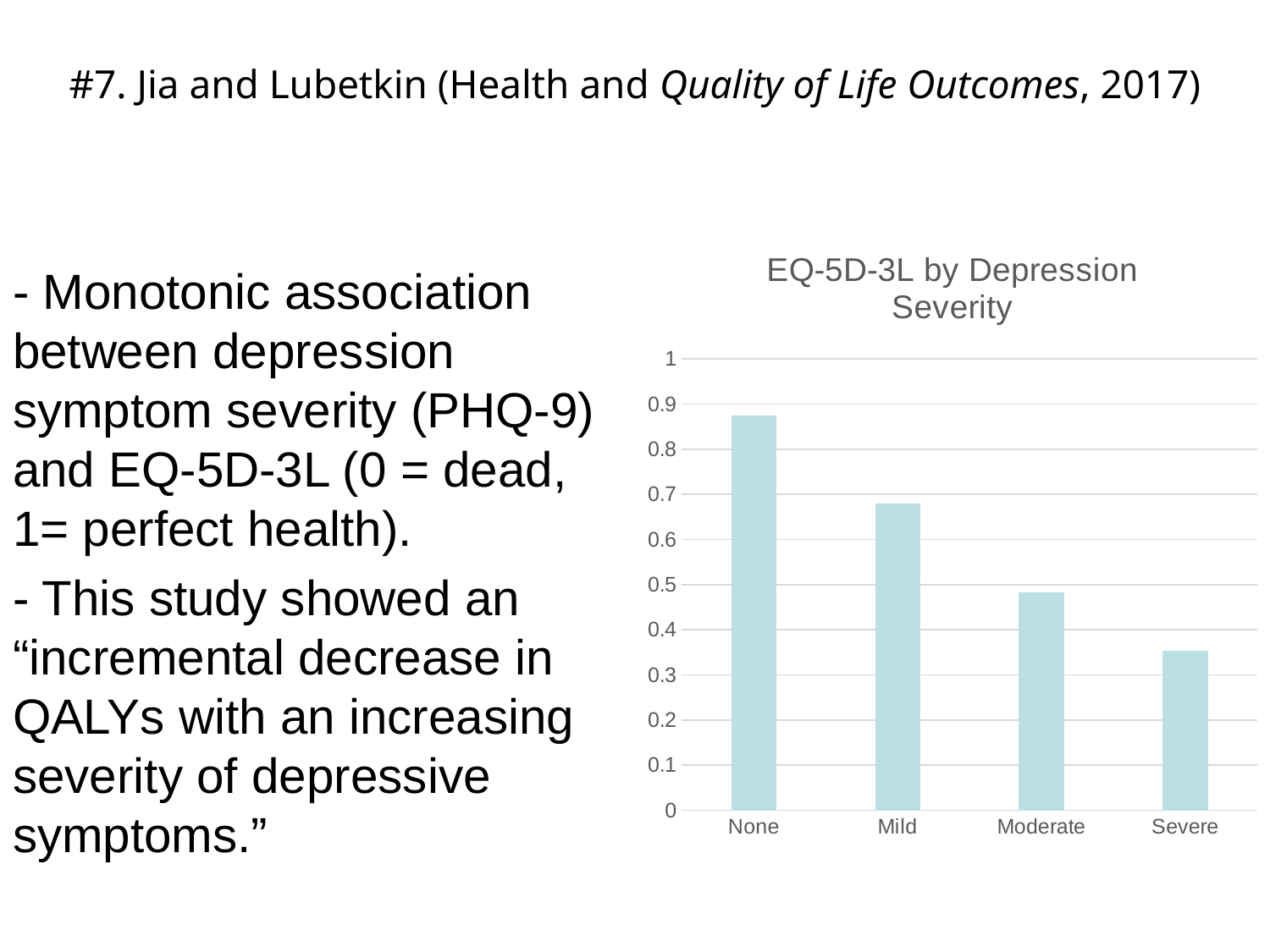
Which depression severity category has the highest EQ-5D-3L value? None Is the value for Severe greater or less than 0.4? less How many depression severity categories are plotted in the chart? 4 Do the EQ-5D-3L values rise or fall as depression severity increases from None to Severe? fall What is the title of the chart? EQ-5D-3L by Depression Severity Which depression severity category has the lowest EQ-5D-3L value? Severe Is the value for Moderate greater or less than 0.4? greater Which has a larger EQ-5D-3L value, Mild or Moderate? Mild Is the value for None greater or less than 0.8? greater Which has a larger EQ-5D-3L value, Severe or None? None What kind of chart is shown on the slide? bar chart